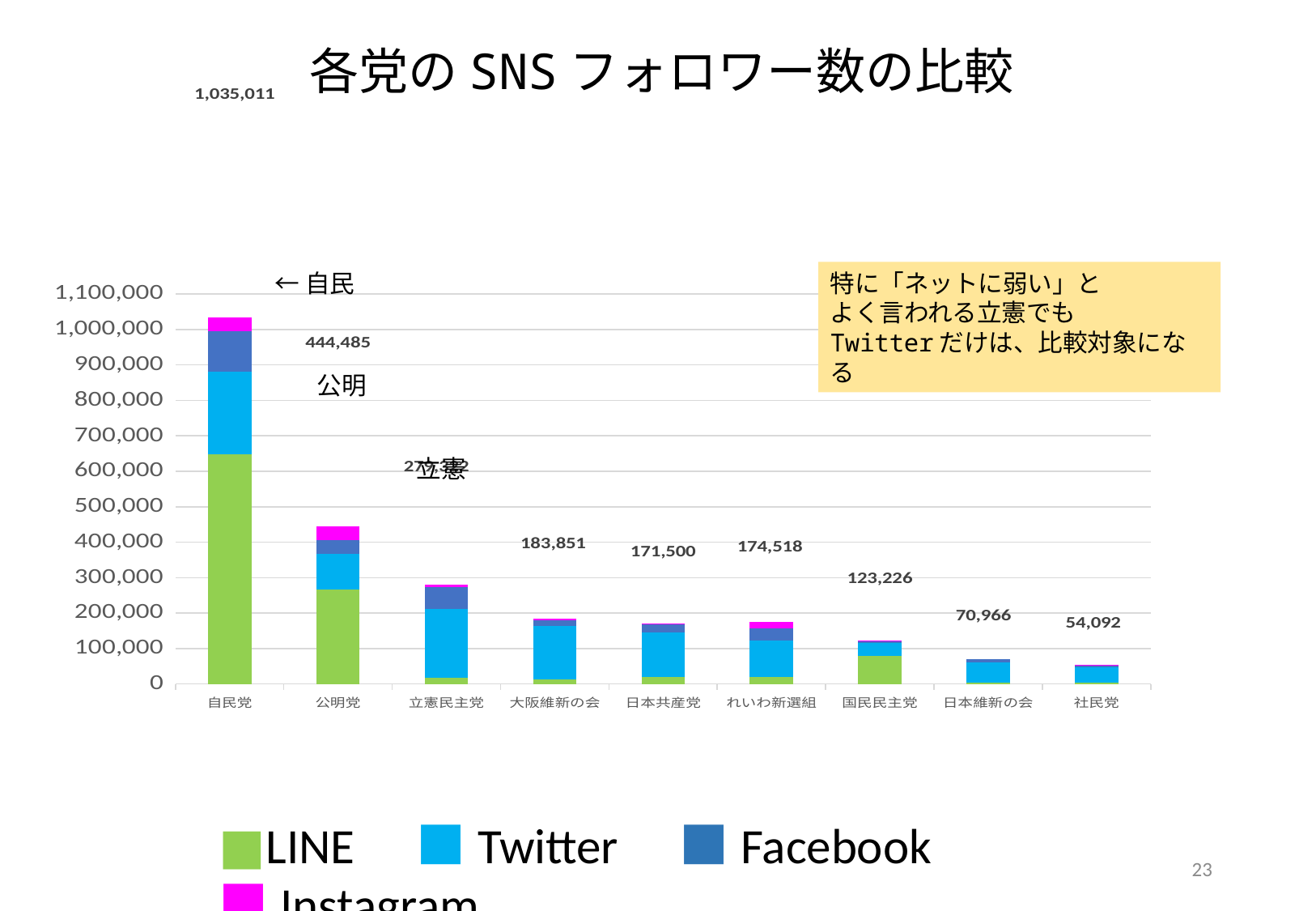
What is the total SNS follower count shown for 社民党? 54,092 How many parties are shown on the x axis? 9 Which party has the lowest total SNS follower count? 社民党 Is the total value for 立憲民主党 greater or less than 300,000? less Which has a larger total follower count, れいわ新選組 or 日本共産党? れいわ新選組 What is the total SNS follower count shown for 公明党? 444,485 What is the total SNS follower count shown for 国民民主党? 123,226 Which party has the highest total SNS follower count? 自民党 What is the difference between the total follower counts of 日本維新の会 and 社民党? 16,874 What is the total SNS follower count shown for 自民党? 1,035,011 What is the difference between the total follower counts of 自民党 and 公明党? 590,526 How many series does the legend list? 4